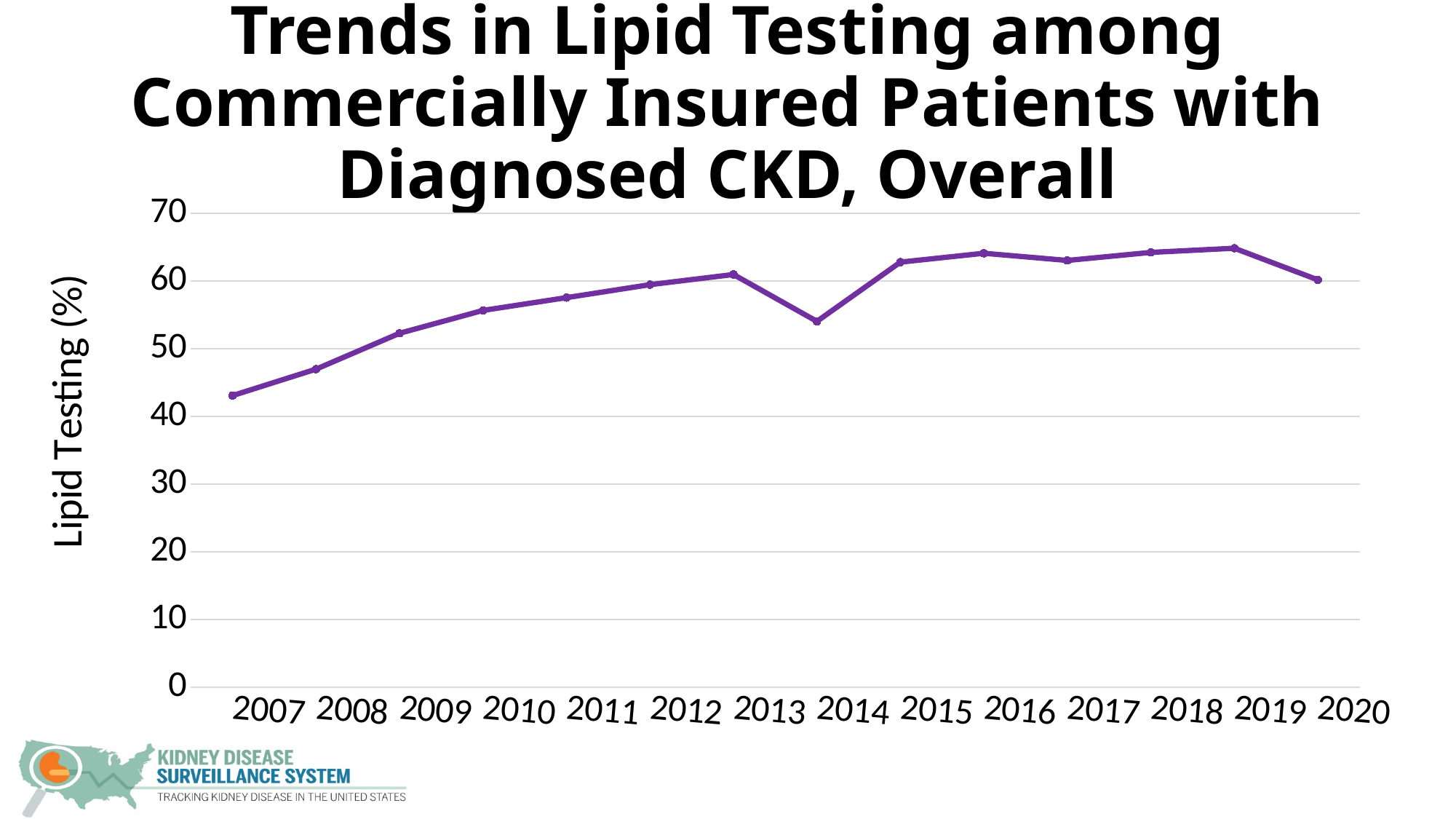
Is the value for 2010 greater or less than 50? greater Does the lipid testing percentage rise or fall from 2019 to 2020? Fall Which year has the lowest lipid testing percentage? 2007 What kind of chart is shown on the slide? Line chart How many years (data points) are plotted on the chart? 14 Is the value for 2015 greater or less than 60? greater Which year has the larger value, 2013 or 2014? 2013 Is the value for 2014 greater or less than 60? less What is the label on the vertical axis? Lipid Testing (%) Does the lipid testing percentage rise or fall from 2007 to 2013? Rise Which year has the larger value, 2007 or 2020? 2020